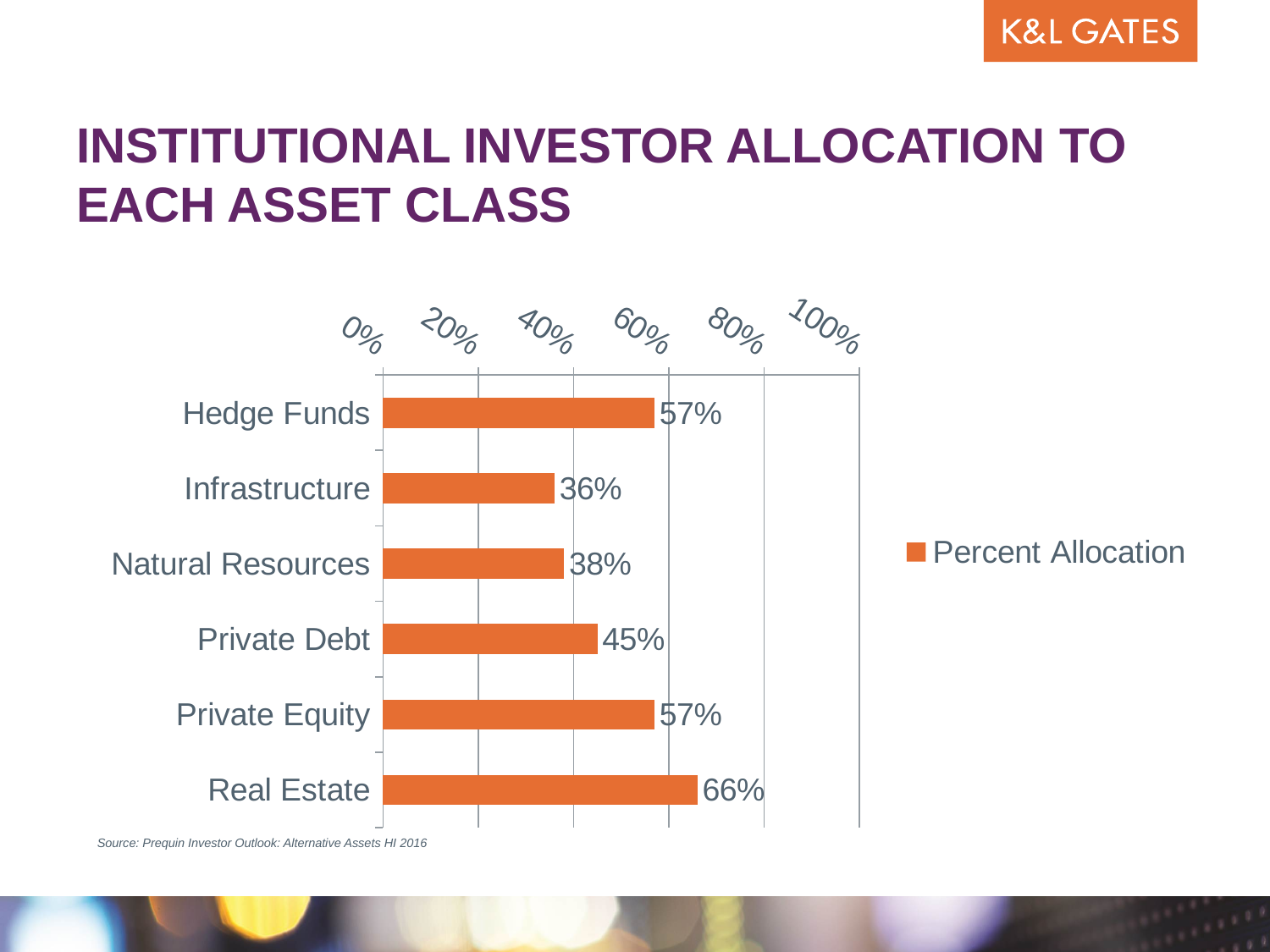
Which asset class has the highest percent allocation? Real Estate How many asset classes are shown in the chart? 6 Is the value for Hedge Funds greater or less than 40%? greater Which asset class has the lowest percent allocation? Infrastructure What kind of chart is shown on the slide? Bar chart What is the percent allocation for Private Debt? 45% Which has a larger percent allocation, Natural Resources or Private Debt? Private Debt How many series does the legend list? 1 What is the name of the series shown in the legend? Percent Allocation What is the percent allocation for Infrastructure? 36% What is the difference between the percent allocation for Real Estate and Private Debt? 21% What is the percent allocation for Real Estate? 66%